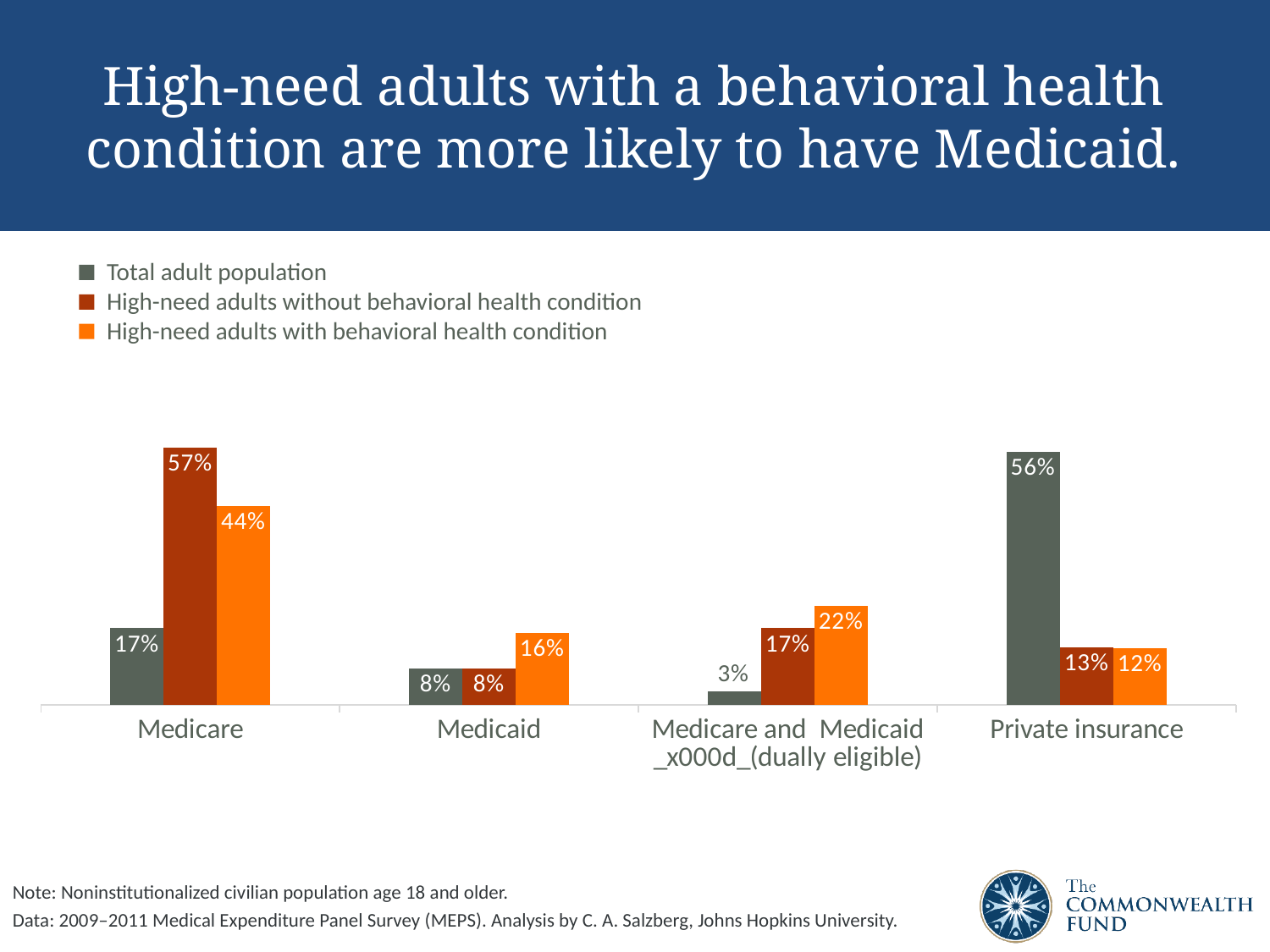
In the Medicare and Medicaid (dually eligible) category, which is larger: high-need adults with a behavioral health condition or the total adult population? High-need adults with behavioral health condition What percentage of high-need adults with a behavioral health condition have Medicaid? 16% What is the difference between high-need adults without and with a behavioral health condition in the Medicare category? 13% What kind of chart is shown on the slide? Bar chart How many series does the legend list? 3 What is the value for the total adult population in the Private insurance category? 56% What percentage of high-need adults without a behavioral health condition have Medicare? 57% Which category has the lowest value for the total adult population? Medicare and Medicaid (dually eligible) How many insurance categories are shown on the x axis? 4 Which colour represents high-need adults with a behavioral health condition? Orange Which category has the highest value for high-need adults with a behavioral health condition? Medicare What is the difference between the total adult population and high-need adults with a behavioral health condition in the Private insurance category? 44%